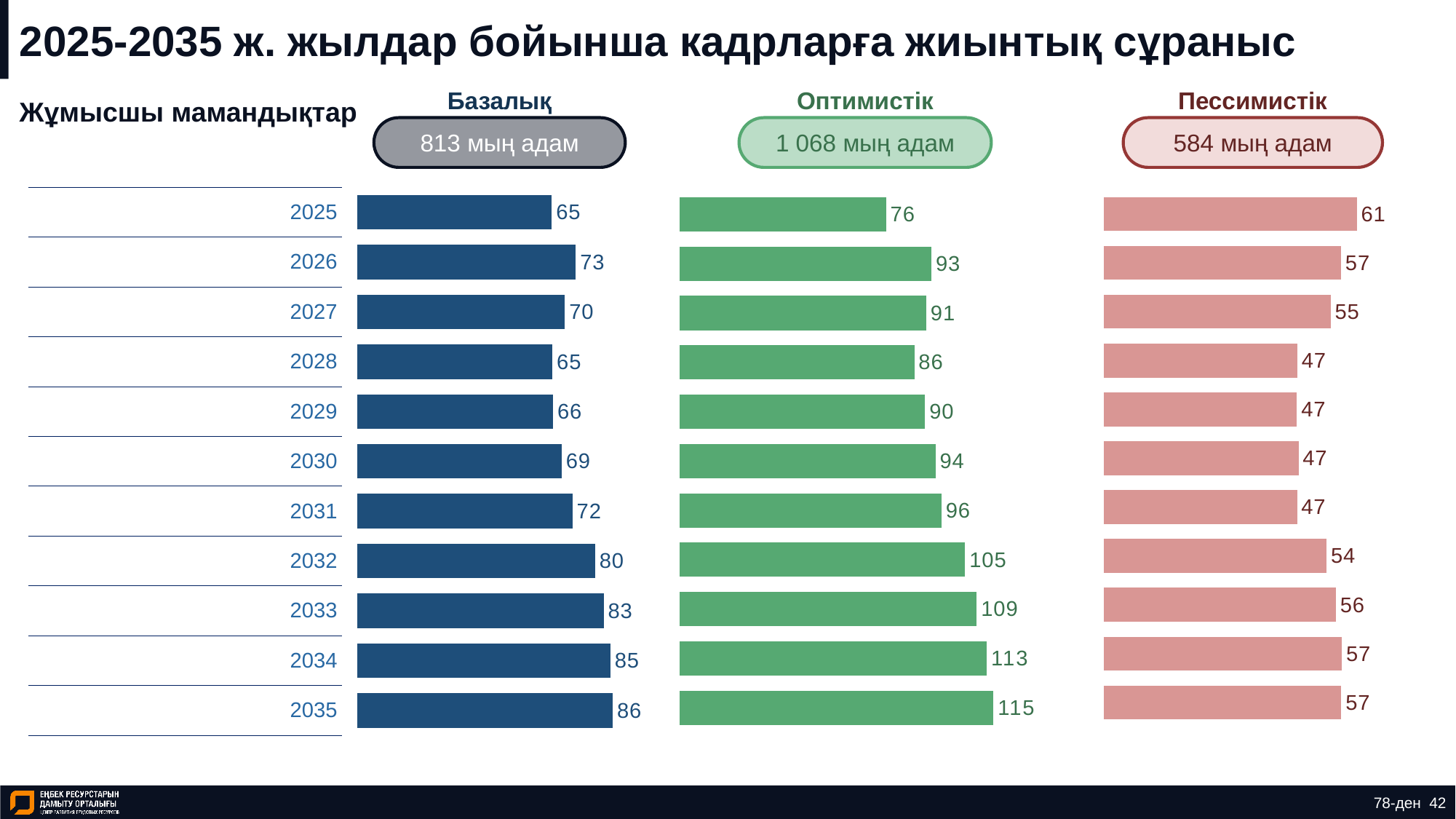
How many years are shown in the Пессимистік chart? 11 In the Базалық chart, which year has the lowest value? 2025 and 2028 In the Базалық chart, what is the value for 2032? 80 In the Оптимистік chart, what is the difference between the values for 2035 and 2025? 39 In the Пессимистік chart, what is the value for 2025? 61 In the Базалық chart, which is larger: the value for 2026 or the value for 2027? 2026 In the Оптимистік chart, do the values generally rise or fall from 2028 to 2035? rise In the Оптимистік chart, which year has the highest value? 2035 In the Оптимистік chart, what is the value for 2028? 86 What kind of chart is the Оптимистік chart? bar chart What total is shown in the label above the Оптимистік chart? 1 068 мың адам In the Пессимистік chart, which year has the highest value? 2025